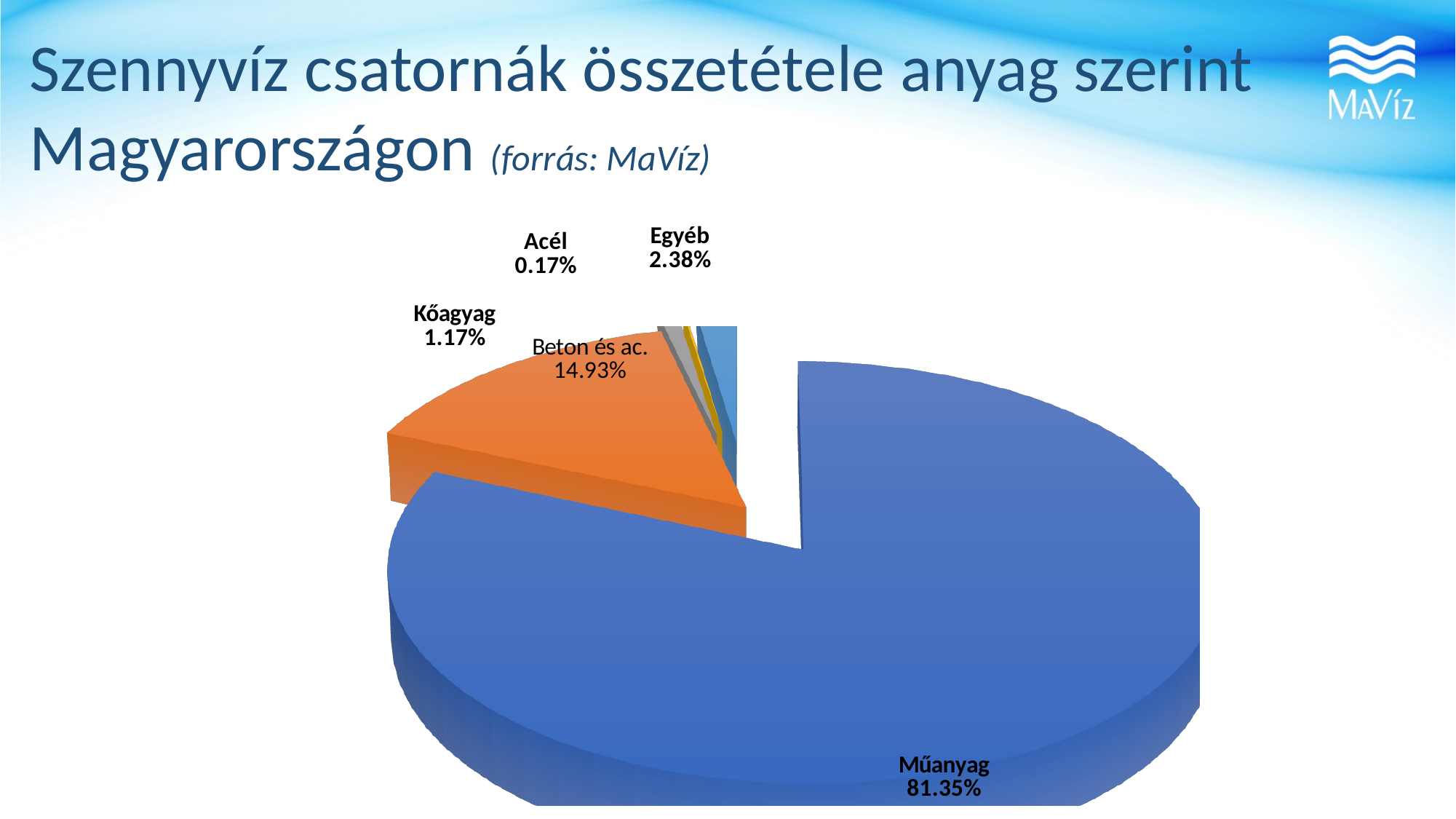
What is the difference between the shares of Műanyag and Beton és ac.? 66.42% How many slices does the pie chart have? 5 What colour is the Műanyag slice? blue What is the value shown for Acél? 0.17% Which is larger, the share for Egyéb or the share for Kőagyag? Egyéb What share of the pie does Műanyag have? 81.35% What is the value shown for Egyéb? 2.38% Which category has the largest share of the pie? Műanyag Which category has the smallest share of the pie? Acél What is the value shown for Kőagyag? 1.17% What is the value shown for Beton és ac.? 14.93% What kind of chart is shown on the slide? pie chart